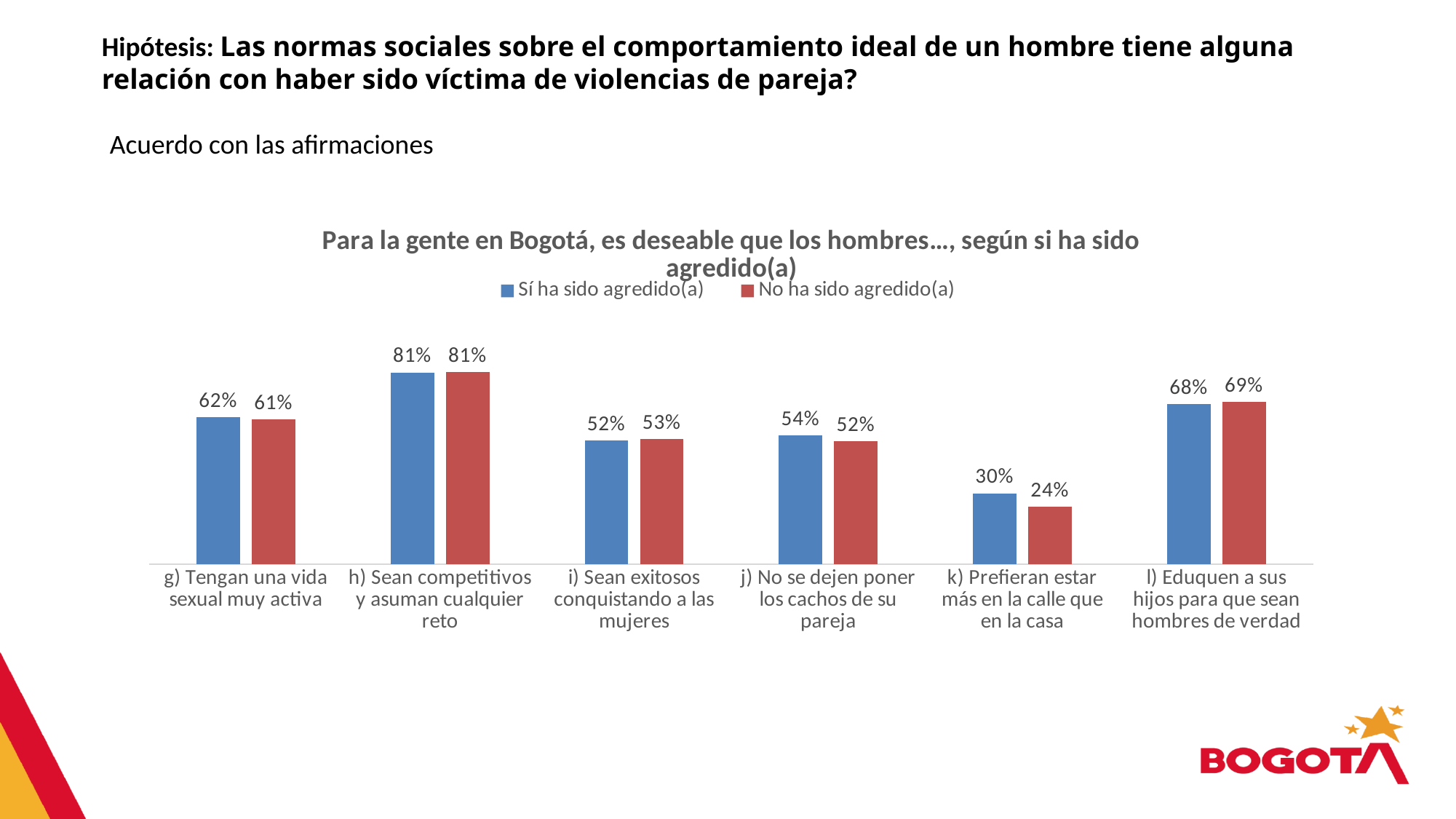
How many series does the legend list? 2 What is the value for 'Sí ha sido agredido(a)' for 'k) Prefieran estar más en la calle que en la casa'? 30% What is the value for 'No ha sido agredido(a)' for 'l) Eduquen a sus hijos para que sean hombres de verdad'? 69% How many categories are shown on the x axis? 6 Which colour represents the 'No ha sido agredido(a)' series? Red What kind of chart is shown on the slide? Bar chart Which category has the highest value for 'No ha sido agredido(a)'? h) Sean competitivos y asuman cualquier reto What is the value for 'Sí ha sido agredido(a)' for 'i) Sean exitosos conquistando a las mujeres'? 52% What is the difference between the 'Sí ha sido agredido(a)' values for 'h) Sean competitivos y asuman cualquier reto' and 'g) Tengan una vida sexual muy activa'? 19% For 'j) No se dejen poner los cachos de su pareja', which series has the larger value? Sí ha sido agredido(a) Which category has the lowest value for 'Sí ha sido agredido(a)'? k) Prefieran estar más en la calle que en la casa What is the difference between the 'Sí ha sido agredido(a)' and 'No ha sido agredido(a)' values for 'k) Prefieran estar más en la calle que en la casa'? 6%